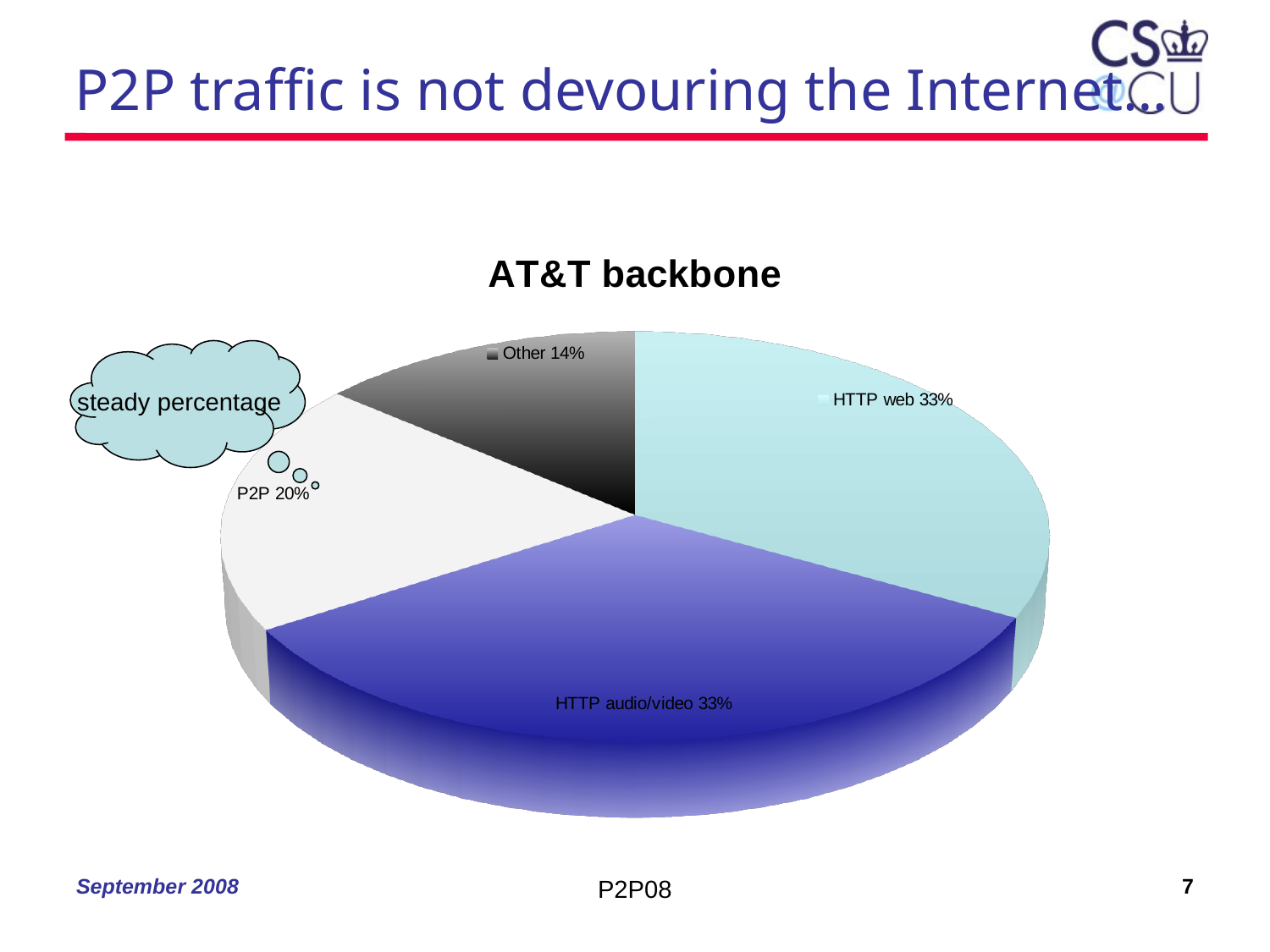
What share of the pie does Other account for? 14% What share of the pie does HTTP audio/video account for? 33% What share of the pie does HTTP web account for? 33% Is the P2P slice greater or less than 25% of the pie? less Which is larger, the P2P slice or the Other slice? P2P Which slice of the pie is the smallest? Other How many slices does the pie chart have? 4 What kind of chart is shown on the slide? pie chart What is the title of the chart? AT&T backbone What is the difference in percentage points between the P2P slice and the Other slice? 6% What is the difference in percentage points between the HTTP web slice and the P2P slice? 13%